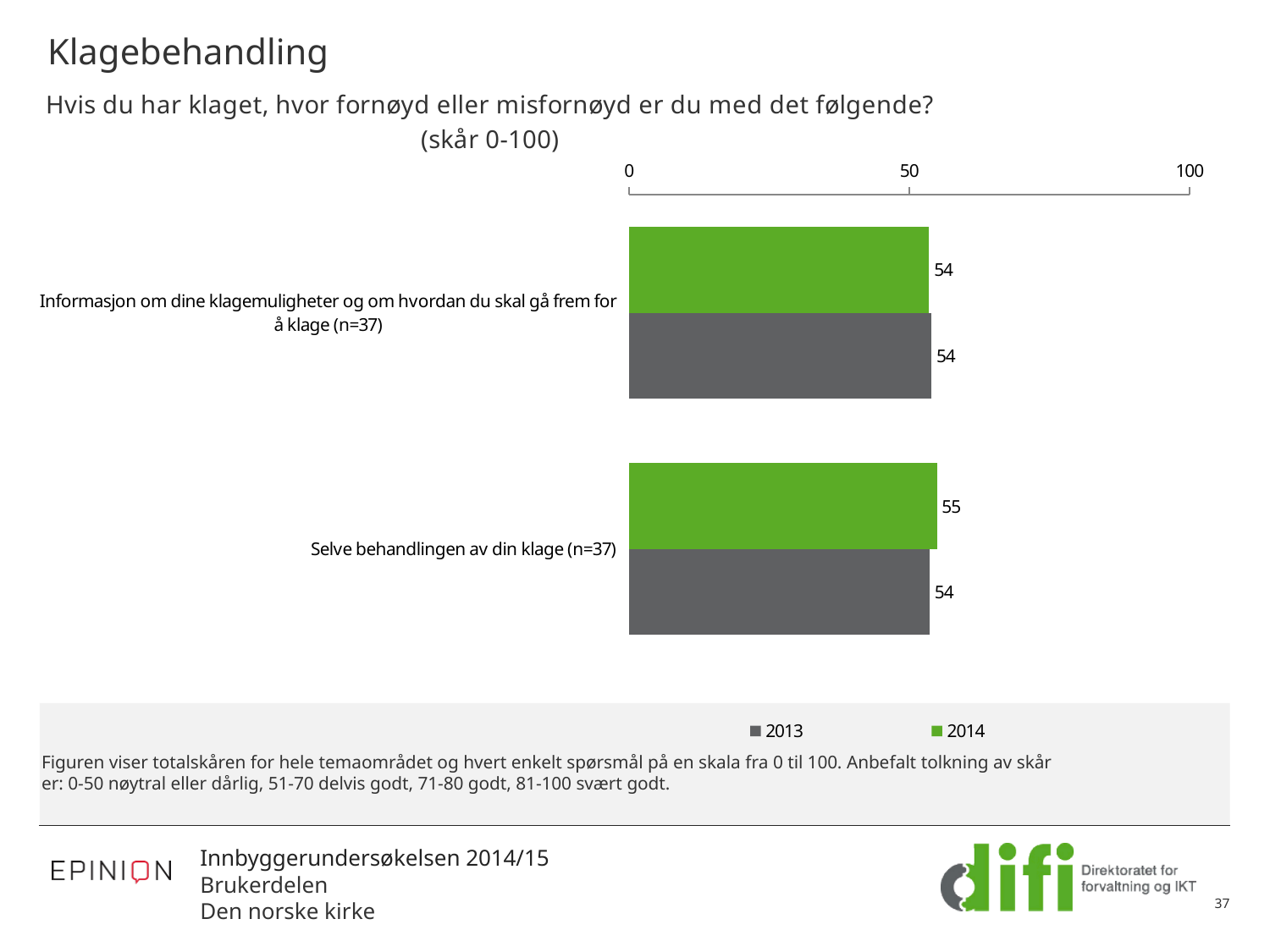
What is the difference between the 2014 and 2013 values for "Selve behandlingen av din klage (n=37)"? 1 What is the 2014 value for "Selve behandlingen av din klage (n=37)"? 55 What kind of chart is shown on the slide? bar chart What is the 2013 value for "Informasjon om dine klagemuligheter og om hvordan du skal gå frem for å klage (n=37)"? 54 What is the 2013 value for "Selve behandlingen av din klage (n=37)"? 54 For "Selve behandlingen av din klage (n=37)", is the 2014 value or the 2013 value larger? 2014 How many categories are shown in the chart? 2 How many series does the legend list? 2 What is the 2014 value for "Informasjon om dine klagemuligheter og om hvordan du skal gå frem for å klage (n=37)"? 54 Which colour represents the 2014 series in the legend? green Which category has the highest 2014 value? Selve behandlingen av din klage (n=37) Is the 2013 value for "Selve behandlingen av din klage (n=37)" greater or less than 50? greater